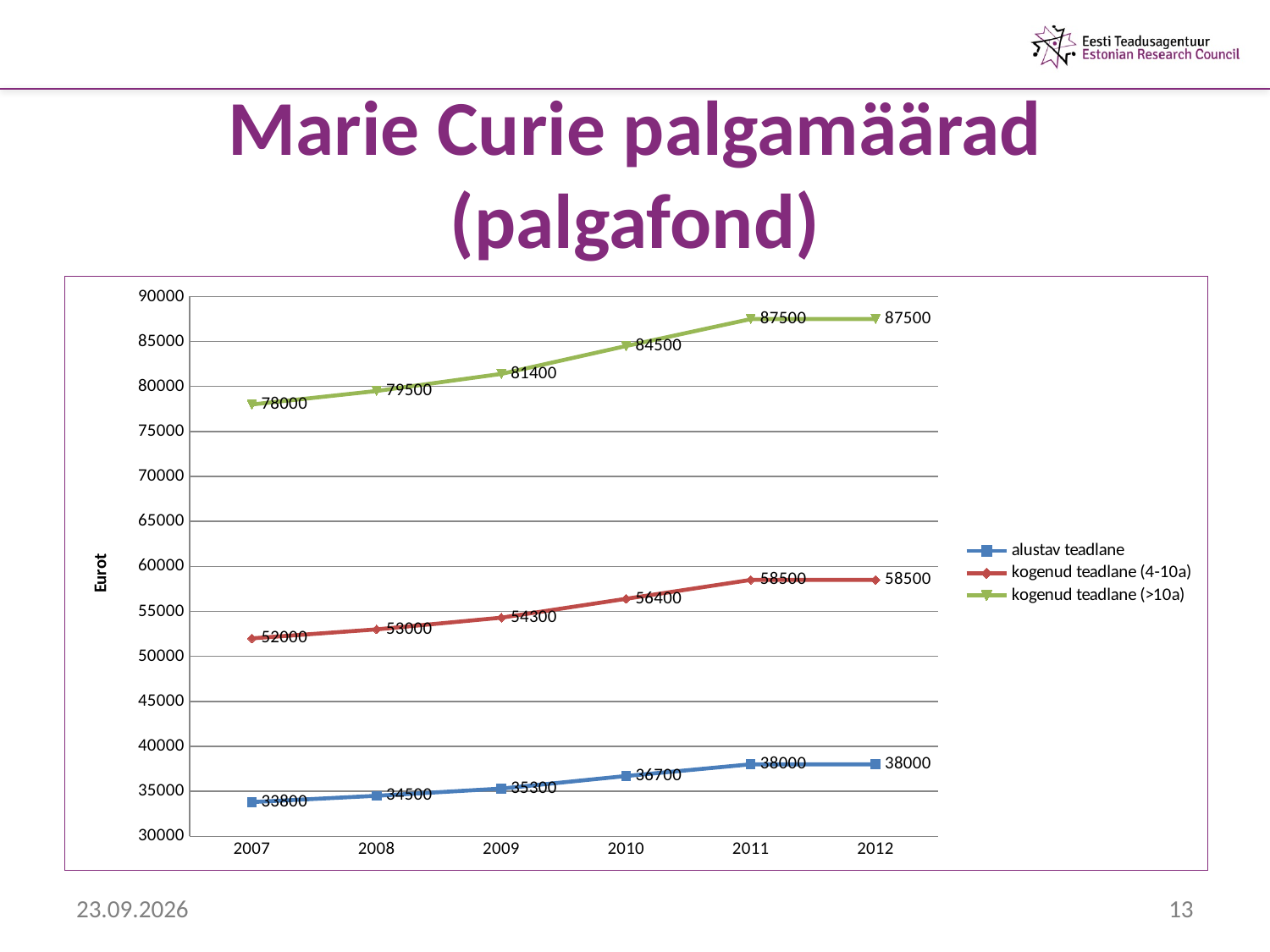
Do the values for 'alustav teadlane' rise or fall from 2007 to 2011? rise Is the value for 'kogenud teadlane (4-10a)' in 2008 greater or less than 55000? less In which year is the value for 'kogenud teadlane (>10a)' lowest? 2007 What is the value for 'alustav teadlane' in 2007? 33800 What is the difference between the 'kogenud teadlane (>10a)' value in 2012 and in 2007? 9500 What is the value for 'kogenud teadlane (4-10a)' in 2010? 56400 How many years are shown on the x axis? 6 What is the value for 'kogenud teadlane (>10a)' in 2009? 81400 Which is larger: the 'alustav teadlane' value in 2010 or in 2008? 2010 What kind of chart is shown on the slide? line chart What is the difference between the 'kogenud teadlane (4-10a)' and 'alustav teadlane' values in 2011? 20500 How many series does the legend list? 3